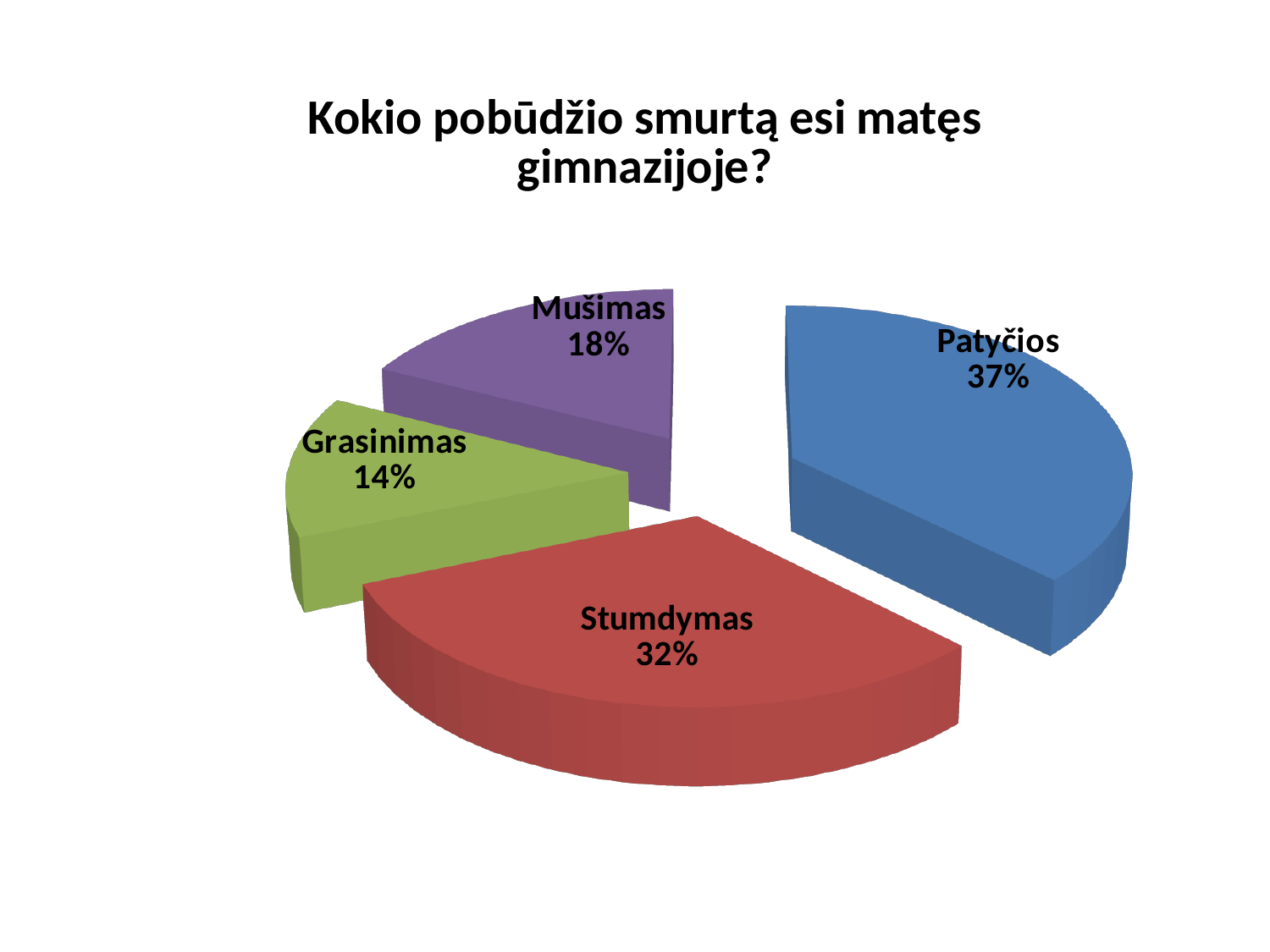
What share of the pie does Patyčios have? 37% How many categories are shown in the pie chart? 4 What is the difference in percentage points between Patyčios and Stumdymas? 5 Which is larger, the share for Stumdymas or the share for Mušimas? Stumdymas What share of the pie does Mušimas have? 18% What is the title of the chart? Kokio pobūdžio smurtą esi matęs gimnazijoje? What share of the pie does Stumdymas have? 32% Which category has the largest share of the pie? Patyčios Which category has the smallest share of the pie? Grasinimas What kind of chart is shown on the slide? Pie chart What is the difference in percentage points between Mušimas and Grasinimas? 4